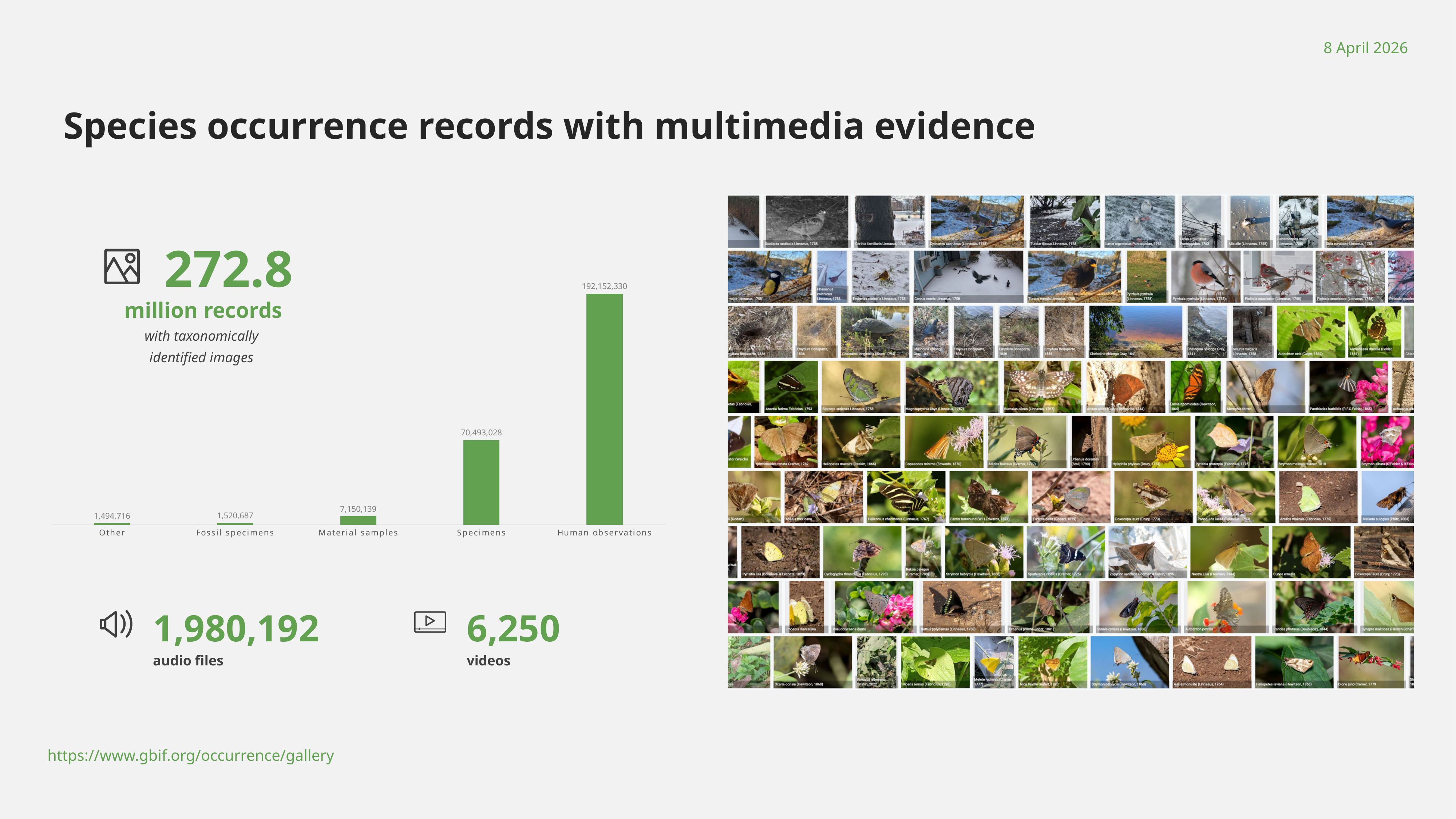
What is the value for Other in the bar chart? 1,494,716 Which category has the highest value in the bar chart? Human observations What is the difference between the values for Specimens and Material samples? 63,342,889 Which category has the lowest value in the bar chart? Other What is the value for Specimens in the bar chart? 70,493,028 What is the value for Fossil specimens in the bar chart? 1,520,687 What kind of chart is shown on the slide? Bar chart What is the difference between the values for Human observations and Specimens? 121,659,302 How many categories are shown in the bar chart? 5 What is the value for Material samples in the bar chart? 7,150,139 What is the value for Human observations in the bar chart? 192,152,330 Which is larger, the value for Specimens or the value for Material samples? Specimens